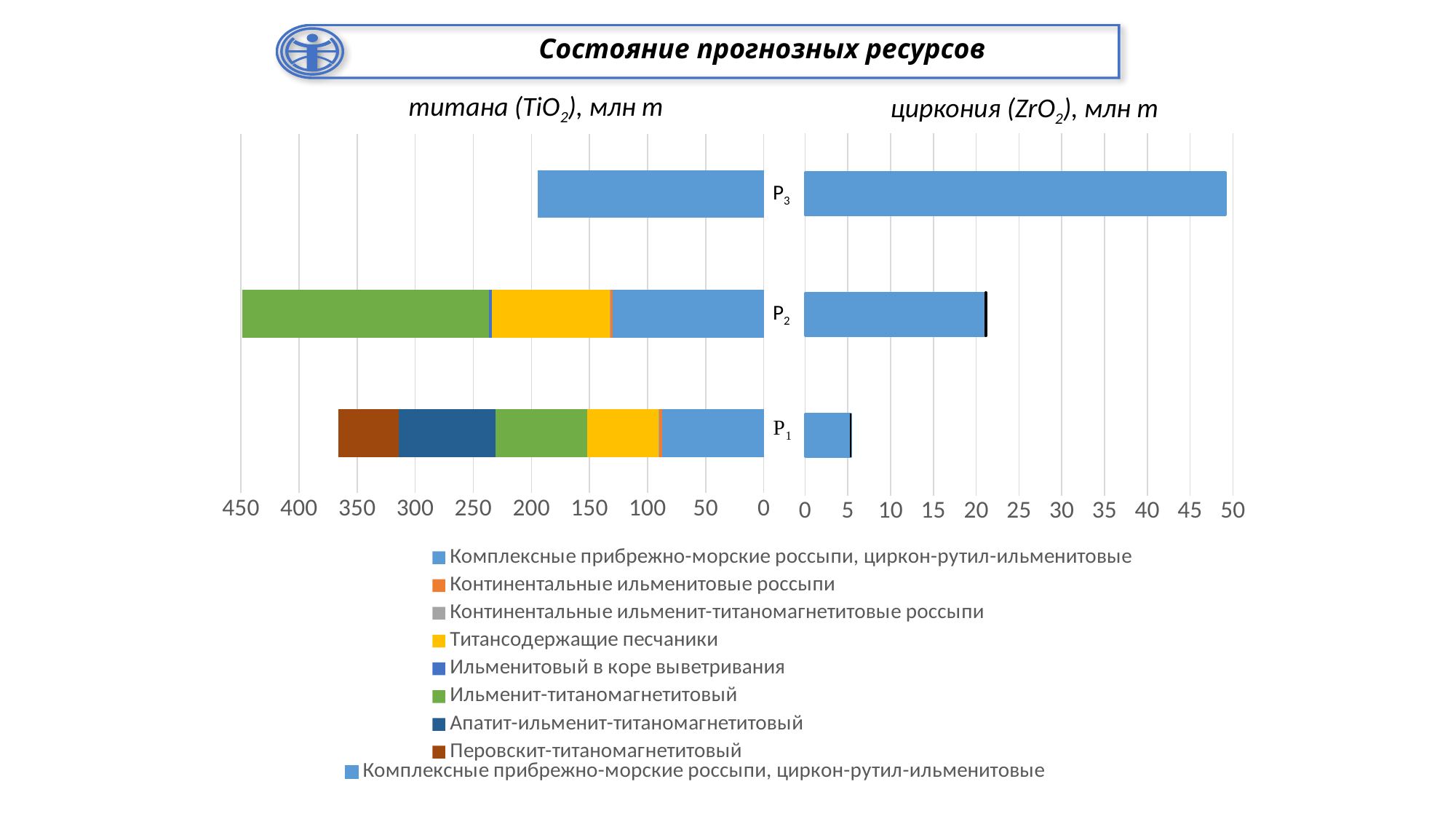
On the циркония (ZrO2), млн т chart, is the value for P3 greater or less than 45? greater On the циркония (ZrO2), млн т chart, which category has the highest value? P3 On the циркония (ZrO2), млн т chart, is the value for P1 greater or less than 10? less On the циркония (ZrO2), млн т chart, is the value for P2 greater or less than 15? greater On the титана (TiO2), млн т chart, which category has the shortest total bar? P3 How many categories are shown on the циркония (ZrO2), млн т chart? 3 On the титана (TiO2), млн т chart, which category has the longest total bar? P2 What kind of chart is the циркония (ZrO2), млн т chart? bar chart What is the title of the slide? Состояние прогнозных ресурсов What kind of chart is the титана (TiO2), млн т chart? bar chart On the циркония (ZrO2), млн т chart, which category has the lowest value? P1